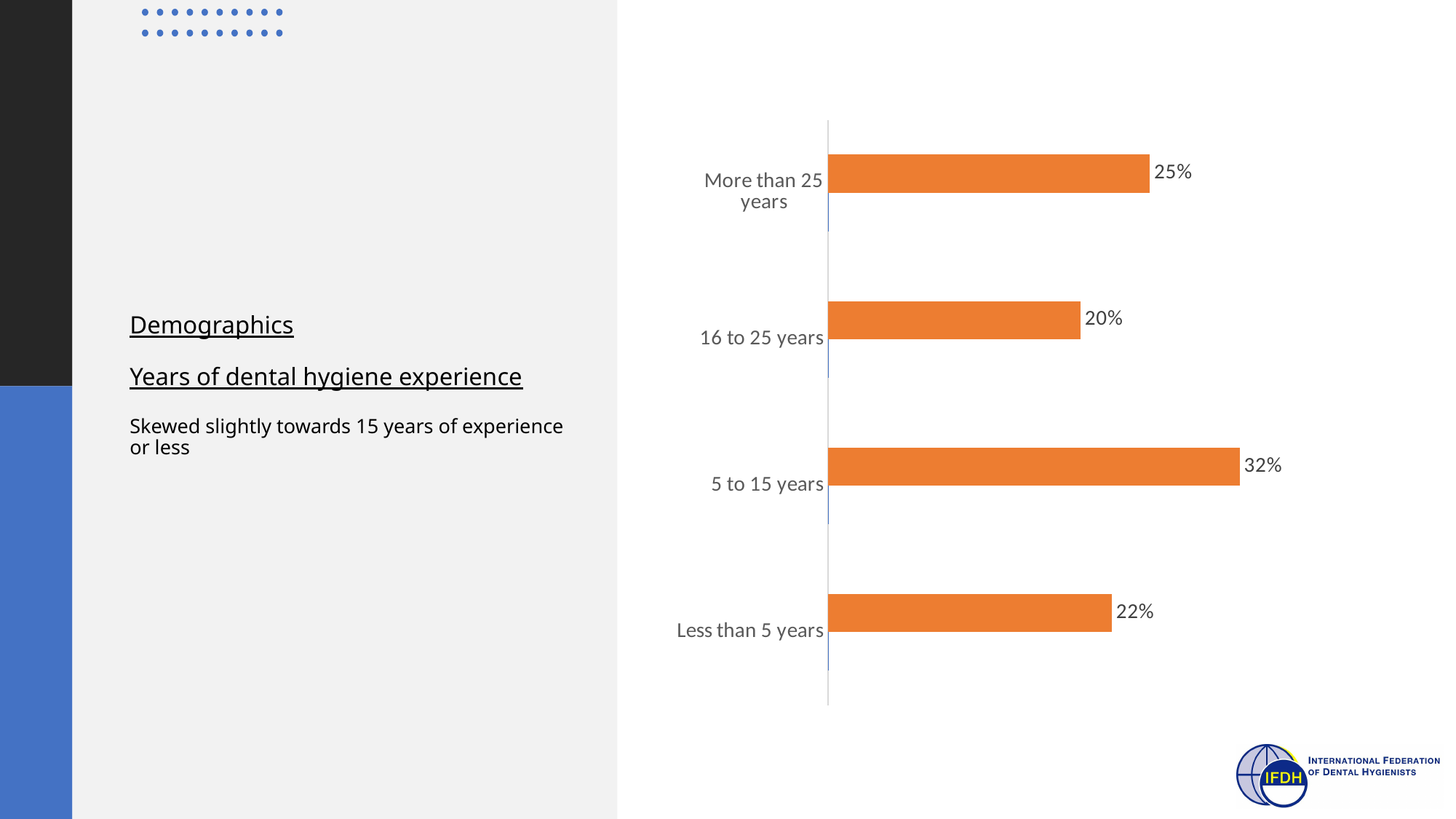
Which experience category has the lowest percentage? 16 to 25 years How many experience categories are shown in the chart? 4 What type of chart is shown on the slide? Bar chart Which is larger: the value for Less than 5 years or the value for More than 25 years? More than 25 years What is the difference in percentage points between the 5 to 15 years and 16 to 25 years categories? 12 What percentage of respondents have more than 25 years of experience? 25% What is the value shown for the 16 to 25 years category? 20% What is the value shown for the Less than 5 years category? 22% What is the difference in percentage points between the More than 25 years and Less than 5 years categories? 3 What percentage of respondents have 5 to 15 years of dental hygiene experience? 32% What colour are the bars in the chart? Orange Which experience category has the highest percentage? 5 to 15 years